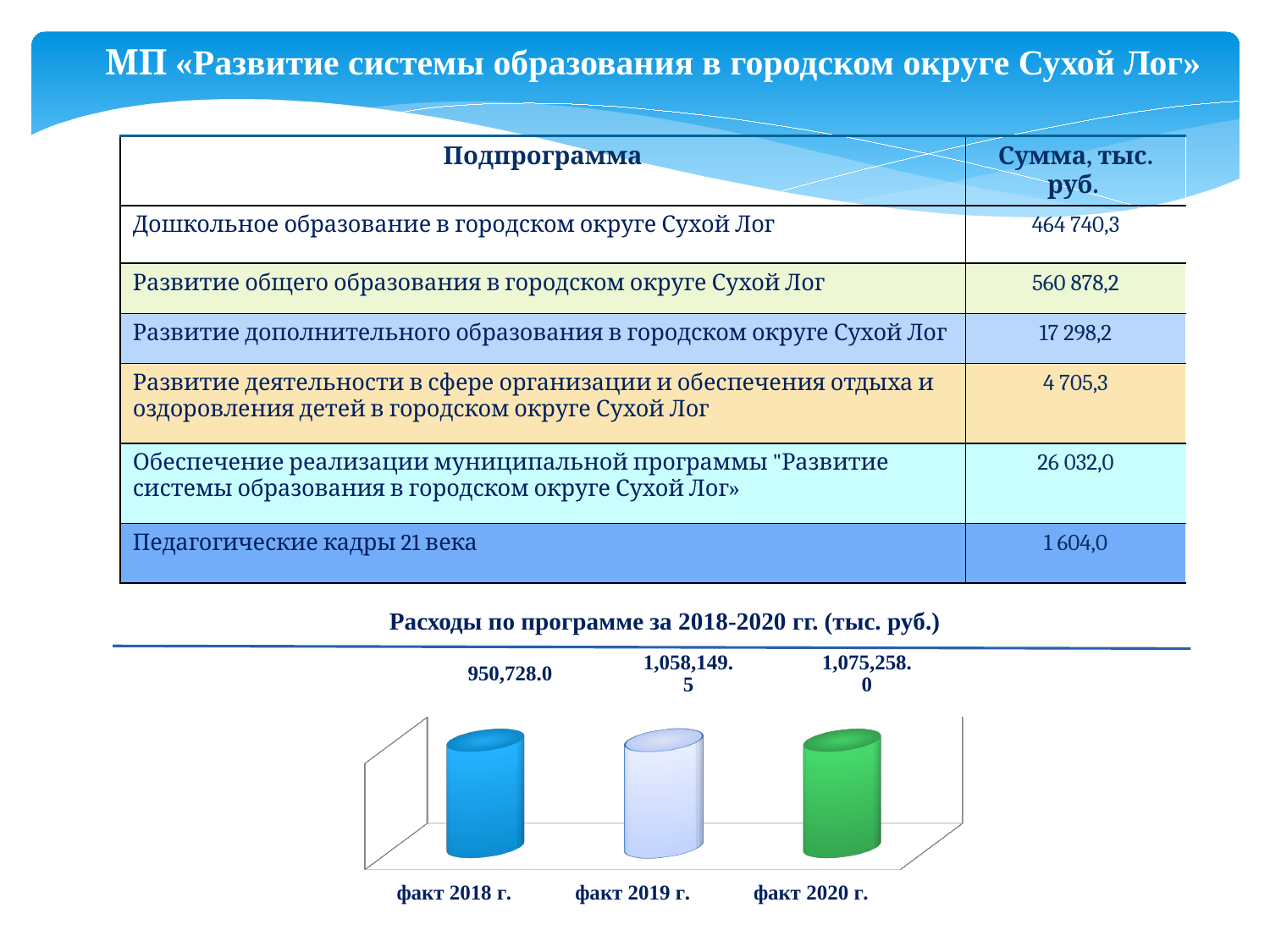
What kind of chart is 'Расходы по программе за 2018-2020 гг. (тыс. руб.)'? Bar chart Which category has the lowest value in the chart 'Расходы по программе за 2018-2020 гг. (тыс. руб.)'? факт 2018 г. What is the value for факт 2019 г. in the chart 'Расходы по программе за 2018-2020 гг. (тыс. руб.)'? 1,058,149.5 What is the value for факт 2018 г. in the chart 'Расходы по программе за 2018-2020 гг. (тыс. руб.)'? 950,728.0 Which category has the highest value in the chart 'Расходы по программе за 2018-2020 гг. (тыс. руб.)'? факт 2020 г. Do the values in the chart 'Расходы по программе за 2018-2020 гг. (тыс. руб.)' rise or fall from факт 2018 г. to факт 2020 г.? Rise How many categories are shown in the chart 'Расходы по программе за 2018-2020 гг. (тыс. руб.)'? 3 In the chart 'Расходы по программе за 2018-2020 гг. (тыс. руб.)', what is the difference between the values for факт 2020 г. and факт 2018 г.? 124,530.0 In the chart 'Расходы по программе за 2018-2020 гг. (тыс. руб.)', what is the difference between the values for факт 2020 г. and факт 2019 г.? 17,108.5 What is the value for факт 2020 г. in the chart 'Расходы по программе за 2018-2020 гг. (тыс. руб.)'? 1,075,258.0 In the chart 'Расходы по программе за 2018-2020 гг. (тыс. руб.)', which is larger: the value for факт 2018 г. or факт 2019 г.? факт 2019 г. In the chart 'Расходы по программе за 2018-2020 гг. (тыс. руб.)', what is the difference between the values for факт 2019 г. and факт 2018 г.? 107,421.5